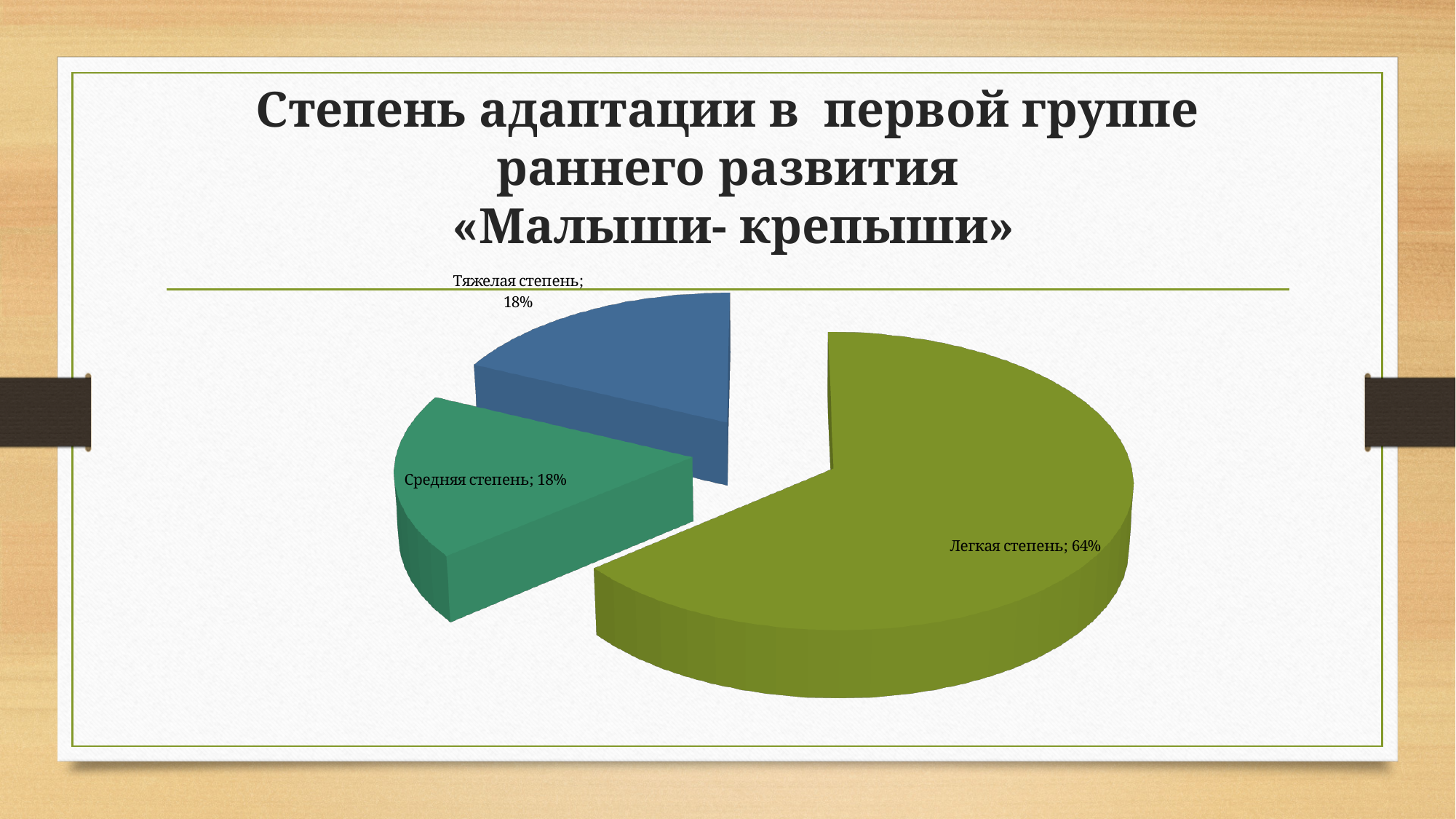
What kind of chart is shown on the slide? Pie chart What is the value shown for Средняя степень? 18% Which category has the largest slice of the pie? Легкая степень What share of the pie does Легкая степень have? 64% Is the value for Легкая степень greater or less than 50%? greater Which is larger, the value for Легкая степень or the value for Тяжелая степень? Легкая степень What is the difference between the values for Легкая степень and Средняя степень? 46% How many slices does the pie chart have? 3 What is the title of the slide? Степень адаптации в первой группе раннего развития «Малыши- крепыши» What colour is the slice for Тяжелая степень? Blue What is the value shown for Тяжелая степень? 18%